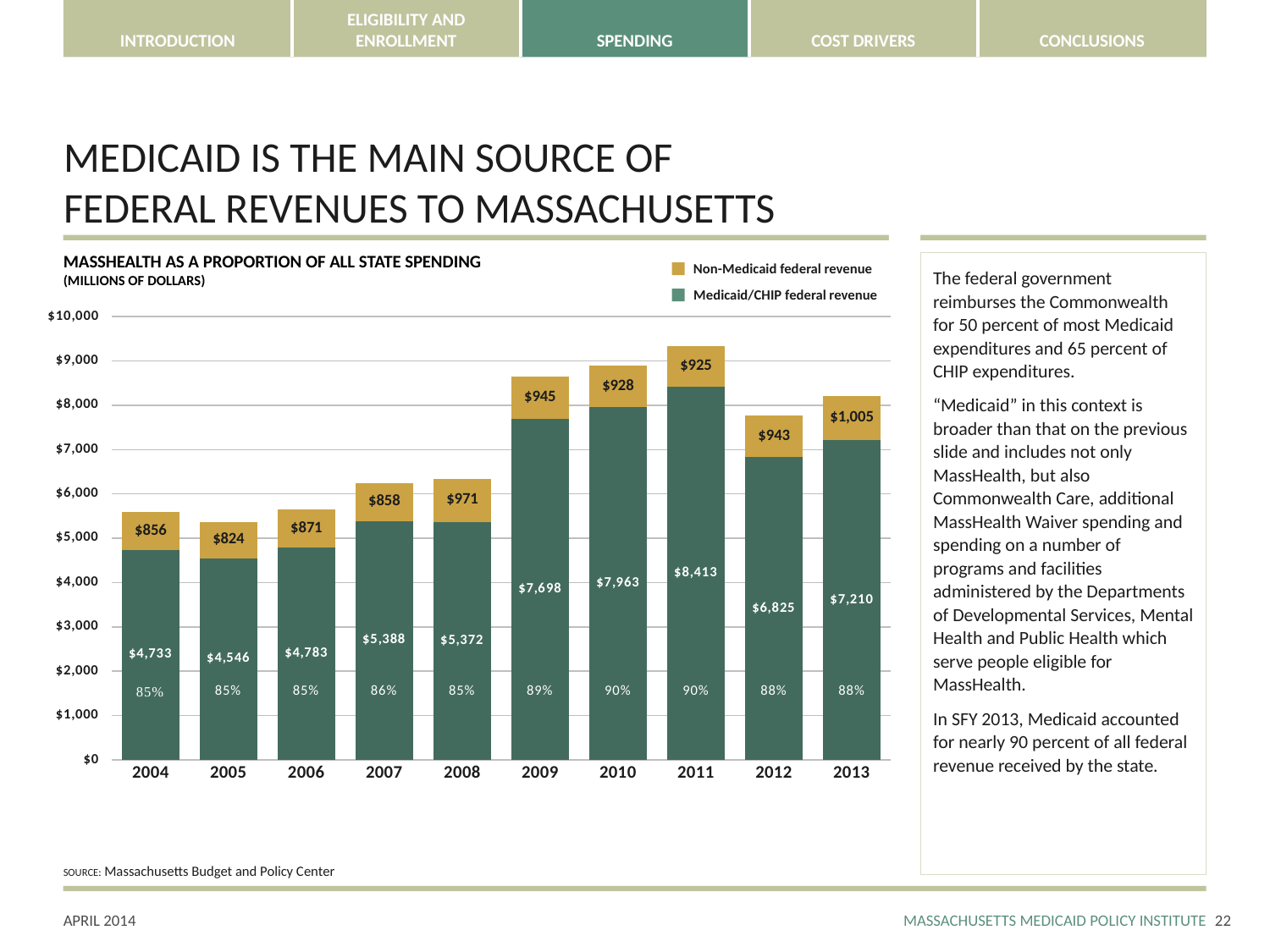
Which year has the lowest Medicaid/CHIP federal revenue? 2005 What percentage label is shown on the 2010 bar? 90% What kind of chart is shown on the slide? Stacked bar chart What is the difference between the Medicaid/CHIP federal revenue in 2010 and in 2009? $265 How many series does the legend list? 2 Which series is shown in green in the chart? Medicaid/CHIP federal revenue Which is larger, the Non-Medicaid federal revenue in 2008 or in 2009? 2008 Which year has the highest Medicaid/CHIP federal revenue? 2011 How many years are shown on the x axis? 10 What is the Non-Medicaid federal revenue value for 2013? $1,005 What is the total of the stacked bar for 2011? $9,338 What is the Medicaid/CHIP federal revenue value for 2011? $8,413